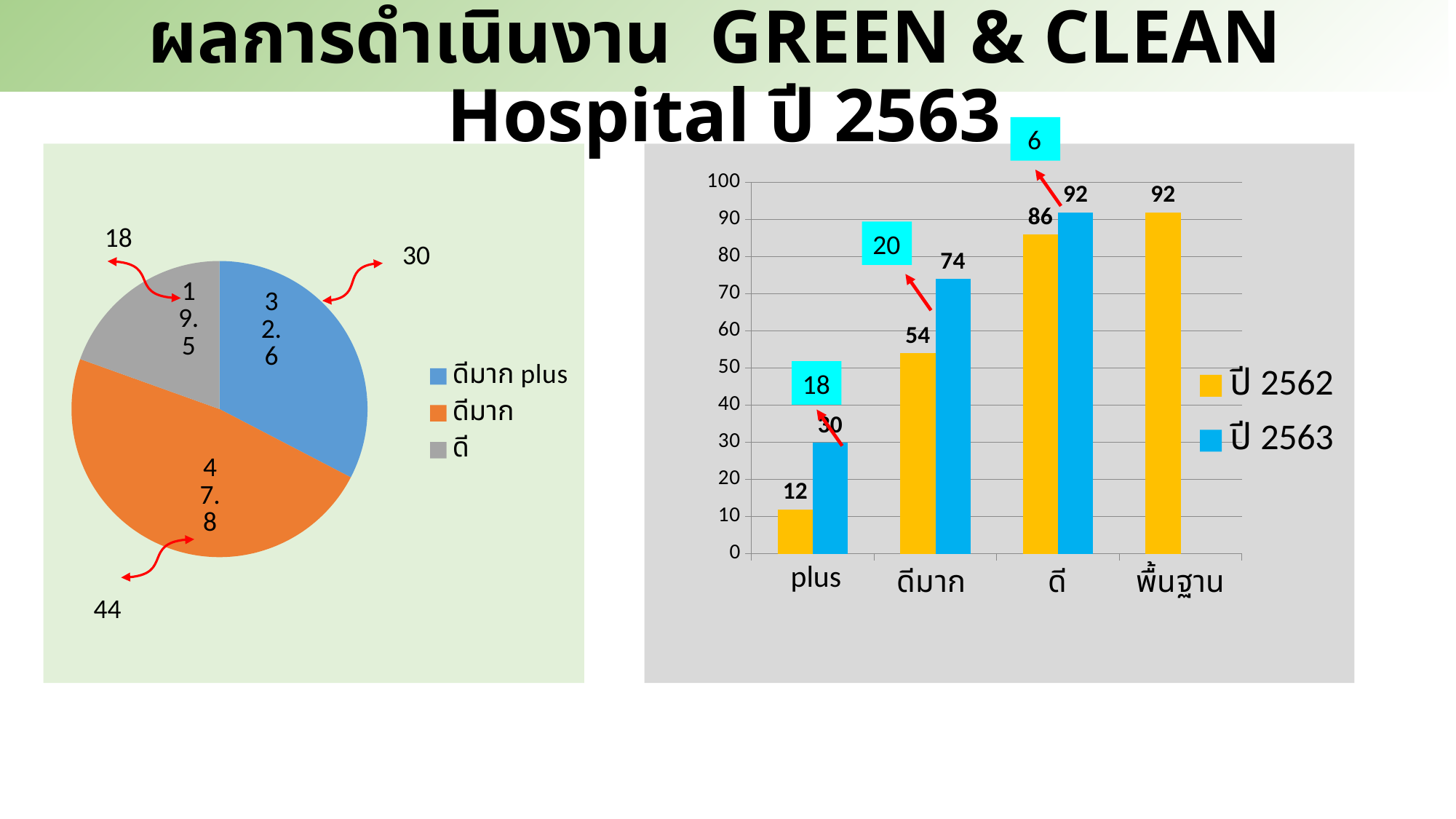
On the pie chart on the left, what is the value shown on the ดีมาก slice? 47.8 On the bar chart on the right, how many series does the legend list? 2 On the bar chart on the right, how many categories are shown on the x axis? 4 On the bar chart on the right, which category has the lowest value in the ปี 2562 series? plus On the bar chart on the right, what is the value for plus in the ปี 2562 series? 12 On the bar chart on the right, what is the difference between the ปี 2563 and ปี 2562 values for ดีมาก? 20 On the bar chart on the right, which is larger for ดี: the ปี 2562 value or the ปี 2563 value? ปี 2563 On the bar chart on the right, what is the value for ดี in the ปี 2563 series? 92 On the bar chart on the right, what is the value for ดีมาก in the ปี 2563 series? 74 What kind of chart is shown on the left of the slide? Pie chart On the pie chart on the left, which slice is the largest? ดีมาก On the bar chart on the right, what is the difference between the ปี 2563 and ปี 2562 values for plus? 18